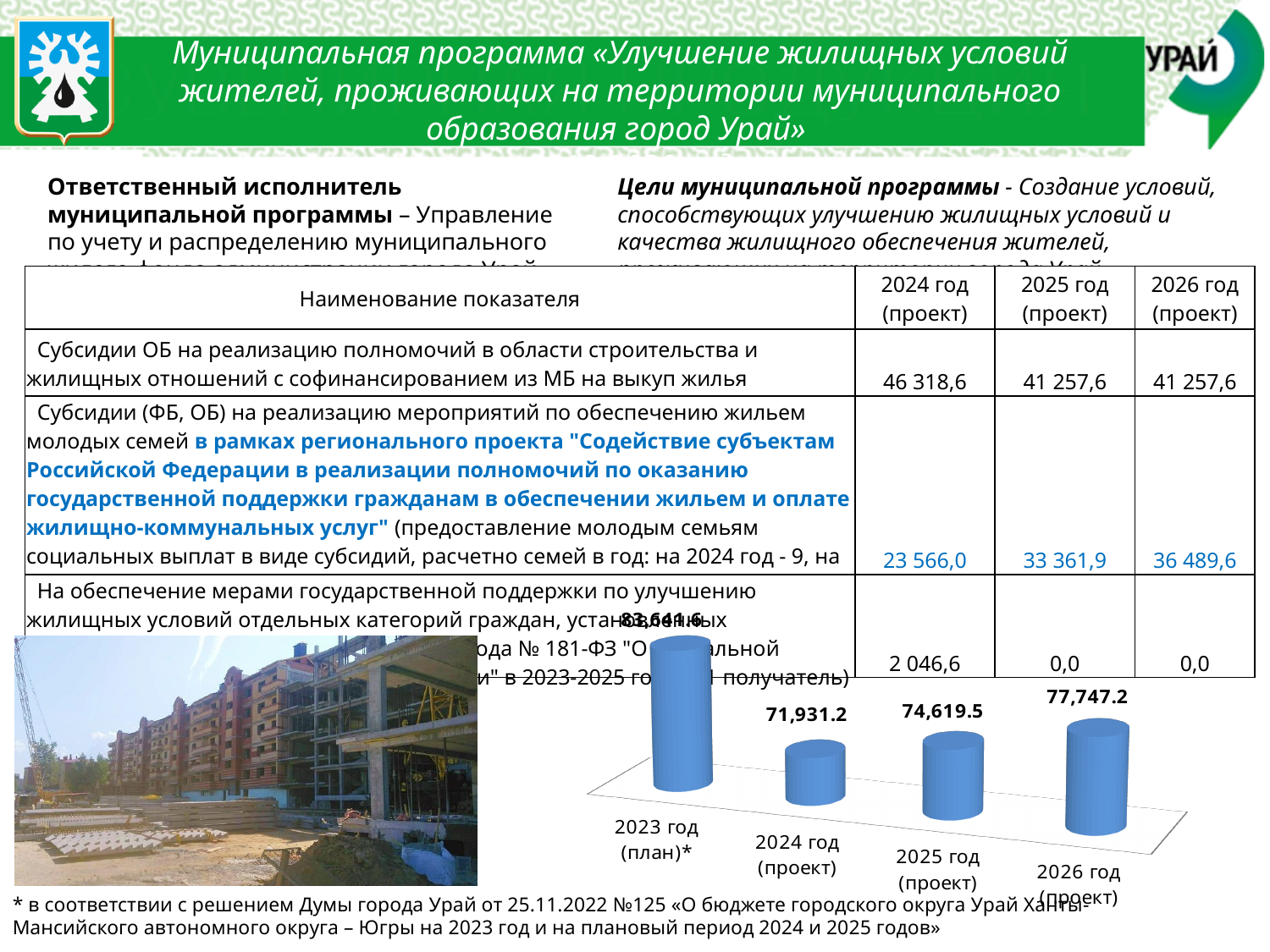
Which category has the highest bar in the chart? 2023 год (план)* Which is larger in the bar chart: the value for 2024 год (проект) or for 2026 год (проект)? 2026 год (проект) How many categories (years) are plotted in the bar chart? 4 Do the values in the bar chart rise or fall from 2024 год (проект) to 2026 год (проект)? rise What is the value shown for 2025 год (проект) in the bar chart? 74,619.5 What is the difference between the values for 2025 год (проект) and 2024 год (проект) in the bar chart? 2,688.3 What is the difference between the values for 2026 год (проект) and 2025 год (проект) in the bar chart? 3,127.7 What is the value shown for 2026 год (проект) in the bar chart? 77,747.2 What kind of chart is shown at the bottom right of the slide? bar chart Which category has the lowest bar in the chart? 2024 год (проект) What is the value shown for 2024 год (проект) in the bar chart? 71,931.2 What colour are the bars in the chart? blue